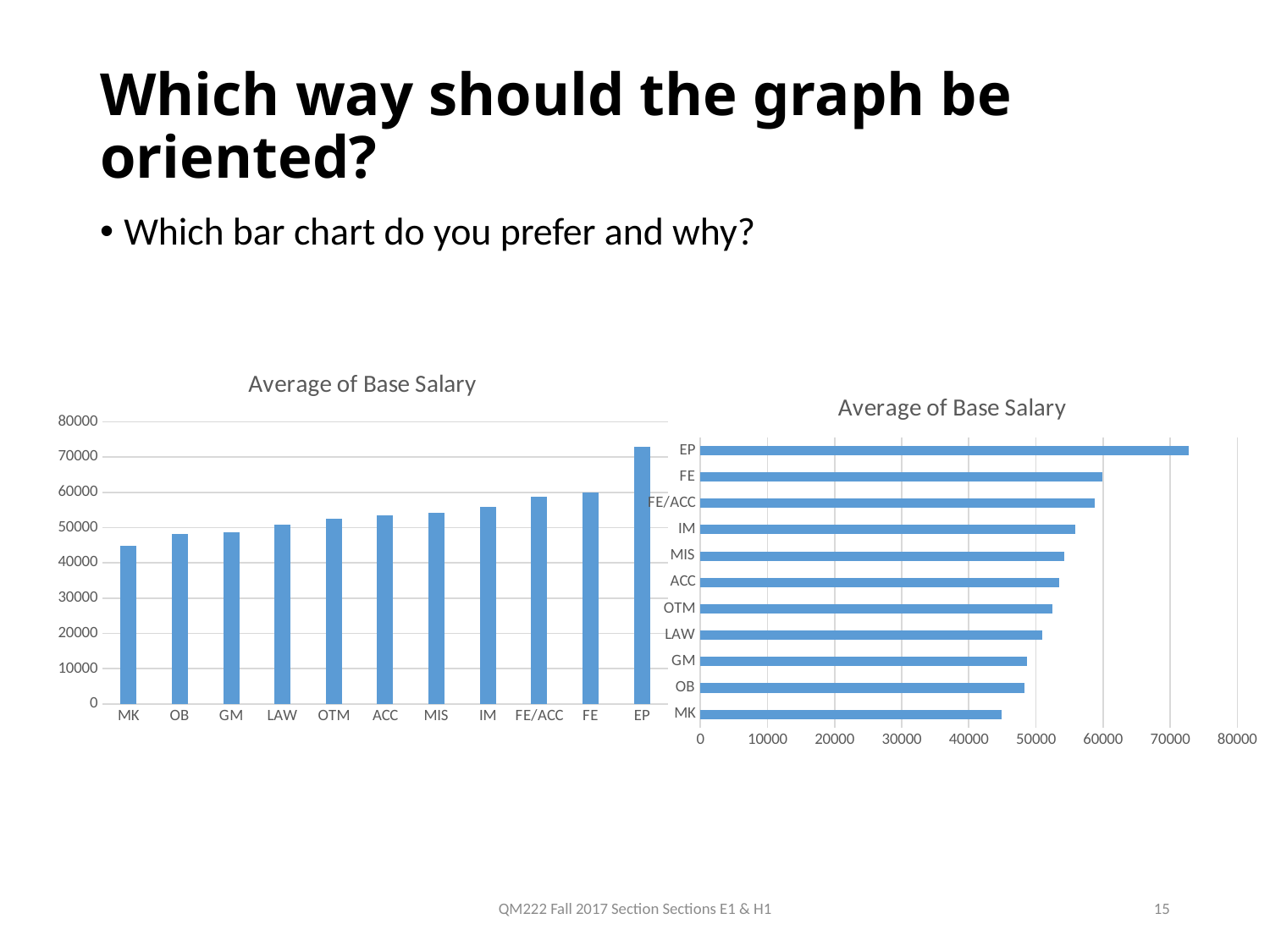
What is the title of the chart on the right of the slide? Average of Base Salary In the right chart, which category has the highest average base salary? EP In the left chart, which is larger, the value for FE or the value for OB? FE In the left chart, which category has the lowest average base salary? MK In the right chart, is the value for OB greater or less than 50000? less In the left chart, is the value for FE/ACC greater or less than 50000? greater In the right chart, is the value for MK greater or less than 50000? less What kind of chart is the chart on the left of the slide? bar chart In the left chart, do the values rise or fall from left to right along the x axis? rise What kind of chart is the chart on the right of the slide? bar chart In the left chart, how many categories are shown on the x axis? 11